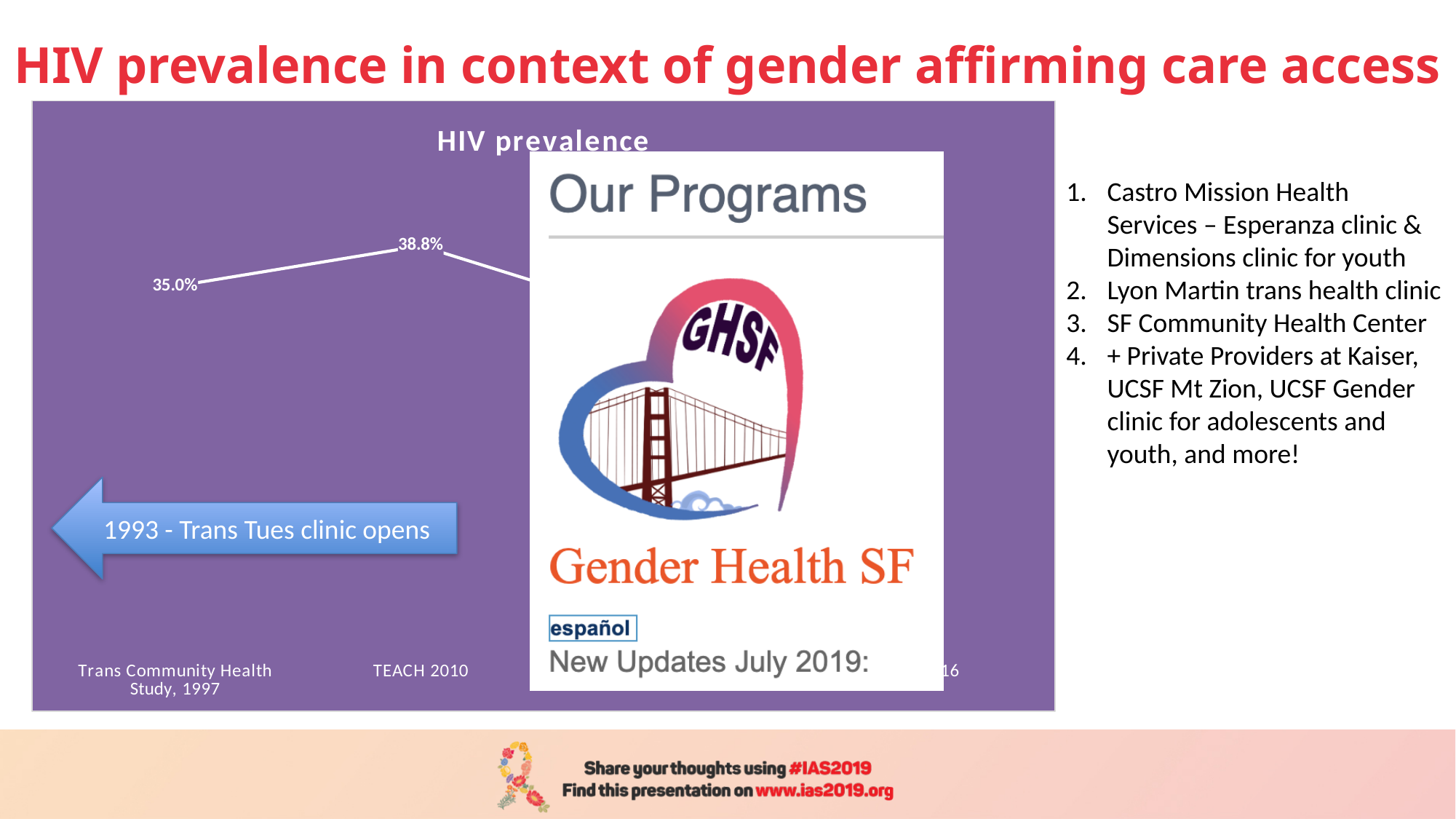
Which has the higher HIV prevalence value: Trans Community Health Study, 1997 or TEACH 2010? TEACH 2010 Does the HIV prevalence value rise or fall from the 1997 study to TEACH 2010? Rise What kind of chart is used to show HIV prevalence on this slide? Line chart What is the HIV prevalence value shown for TEACH 2010? 38.8% What text is written in the blue arrow overlaid on the chart? 1993 - Trans Tues clinic opens By how many percentage points does the TEACH 2010 value exceed the Trans Community Health Study, 1997 value? 3.8 What is the title of the chart on the slide? HIV prevalence What is the HIV prevalence value shown for the Trans Community Health Study, 1997? 35.0%